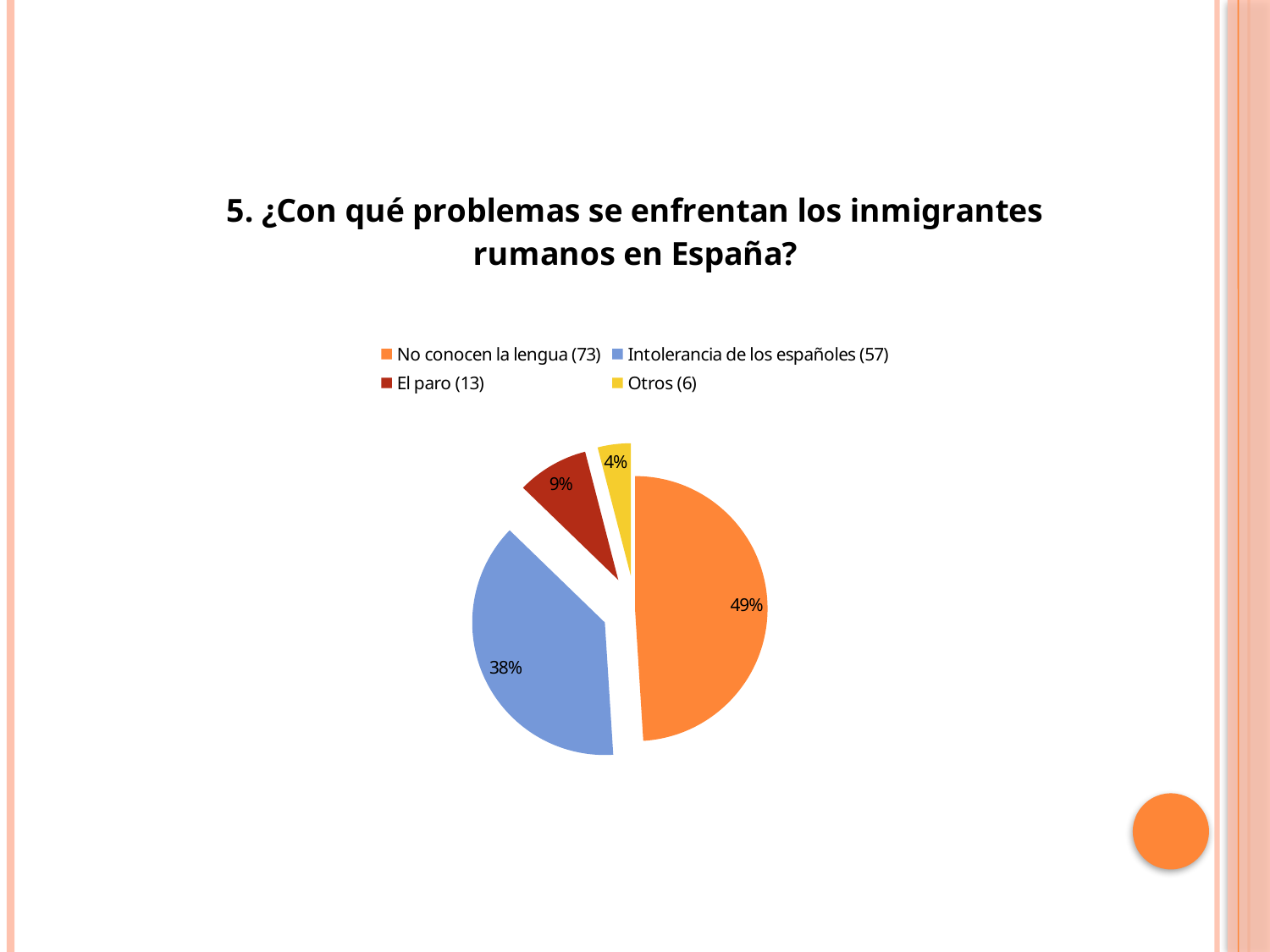
How many slices does the pie chart have? 4 What percentage share does the slice 'Intolerancia de los españoles (57)' have? 38% What percentage share does the slice 'No conocen la lengua (73)' have? 49% Which category has the largest slice of the pie? No conocen la lengua (73) What percentage share does the slice 'El paro (13)' have? 9% What is the difference in percentage points between the 'No conocen la lengua (73)' slice and the 'Intolerancia de los españoles (57)' slice? 11% What is the title of the chart? 5. ¿Con qué problemas se enfrentan los inmigrantes rumanos en España? What kind of chart is shown on the slide? pie chart Which category has the smallest slice of the pie? Otros (6) Which slice is larger: 'El paro (13)' or 'Otros (6)'? El paro (13) What colour is the slice for 'Intolerancia de los españoles (57)'? blue